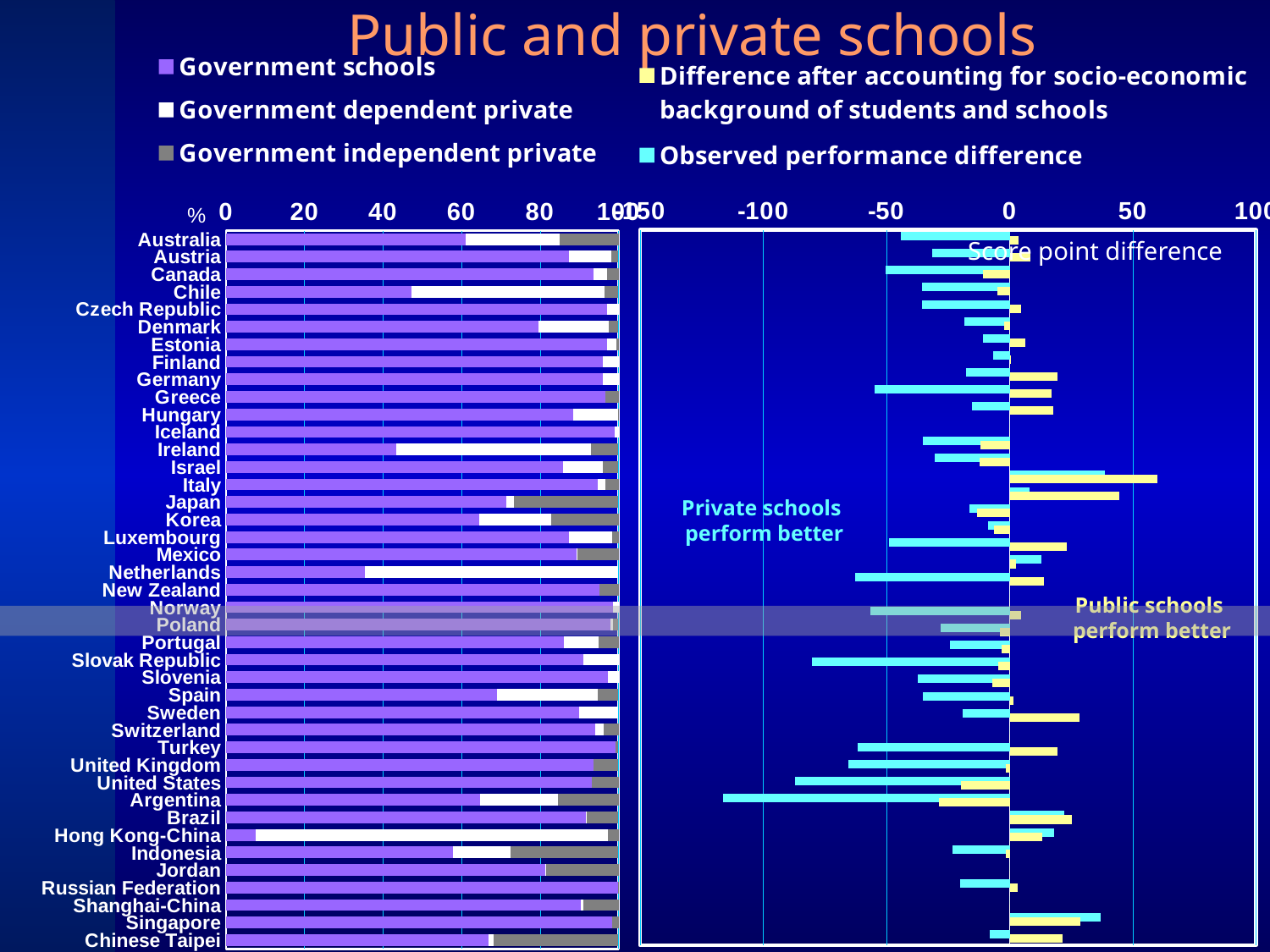
What kind of chart is the left-hand chart showing the share of students by school type? bar chart In the left-hand chart, which country has the lowest share of students in government schools? Hong Kong-China How many series does the legend of the right-hand chart (score point difference) list? 2 In the left-hand chart, which has a larger share of students in government schools, Chile or the Netherlands? Chile In the left-hand chart, is the share of students in government schools for the Netherlands greater or less than 40%? less In the right-hand chart, is the observed performance difference for the United States greater or less than -50? less How many series does the legend of the left-hand chart (school types) list? 3 What is the title of the slide's chart? Public and private schools In the left-hand chart, is the share of students in government schools for Japan greater or less than 60%? greater How many countries are listed along the vertical axis of the charts? 41